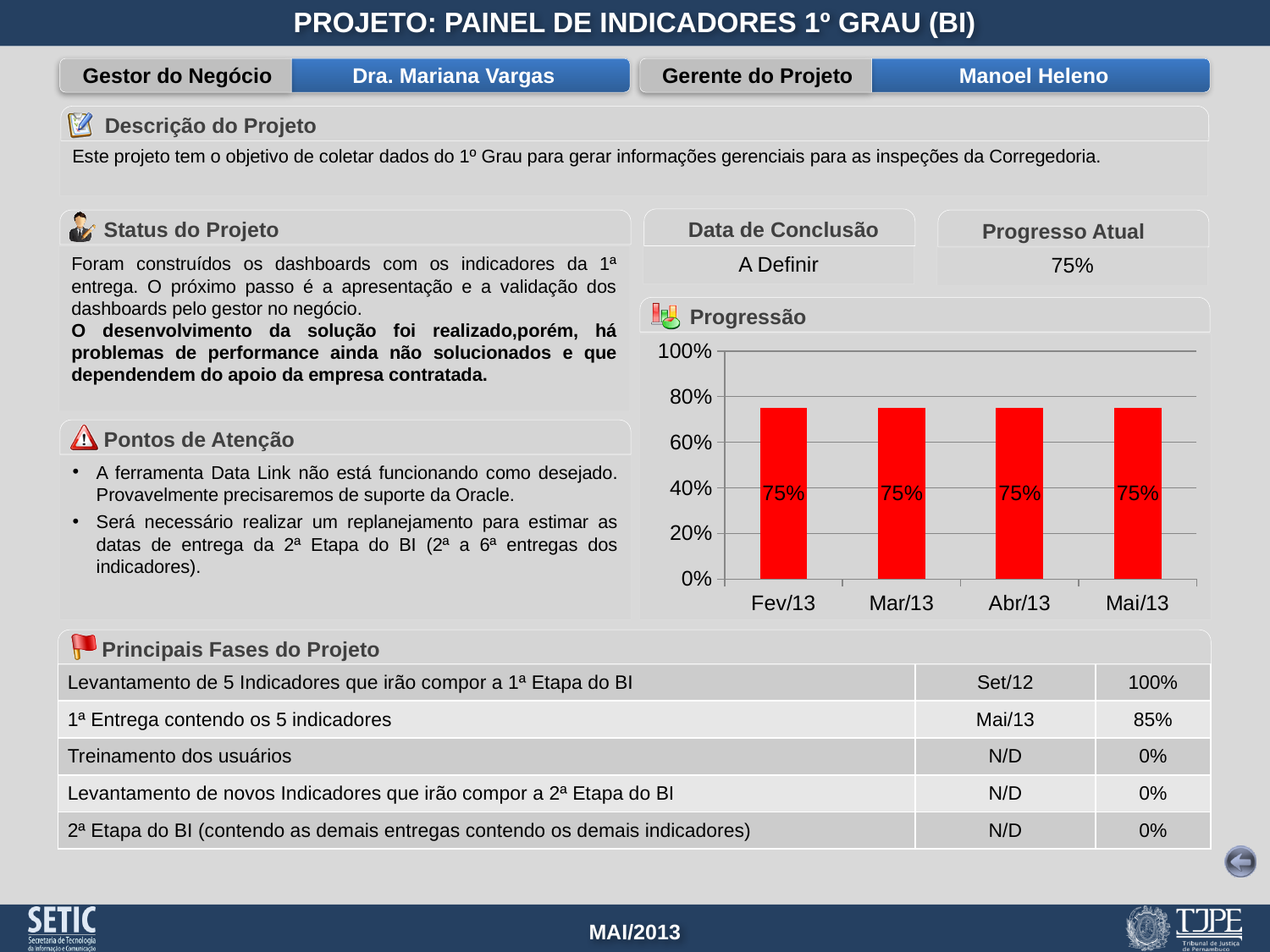
What is the value for Mai/13 in the Progressão chart? 75% What kind of chart is the Progressão chart? bar chart What is the title of the chart on the slide? Progressão How many categories are shown on the x axis of the Progressão chart? 4 What is the value for Fev/13 in the Progressão chart? 75% Do the values in the Progressão chart rise, fall or stay flat from Fev/13 to Mai/13? stay flat What is the highest value shown on the y axis of the Progressão chart? 100% Is the value for Abr/13 in the Progressão chart greater or less than 80%? less What is the difference between the values for Mar/13 and Fev/13 in the Progressão chart? 0% What colour are the bars in the Progressão chart? red What is the value for Abr/13 in the Progressão chart? 75% Is the value for Mar/13 in the Progressão chart greater or less than 60%? greater